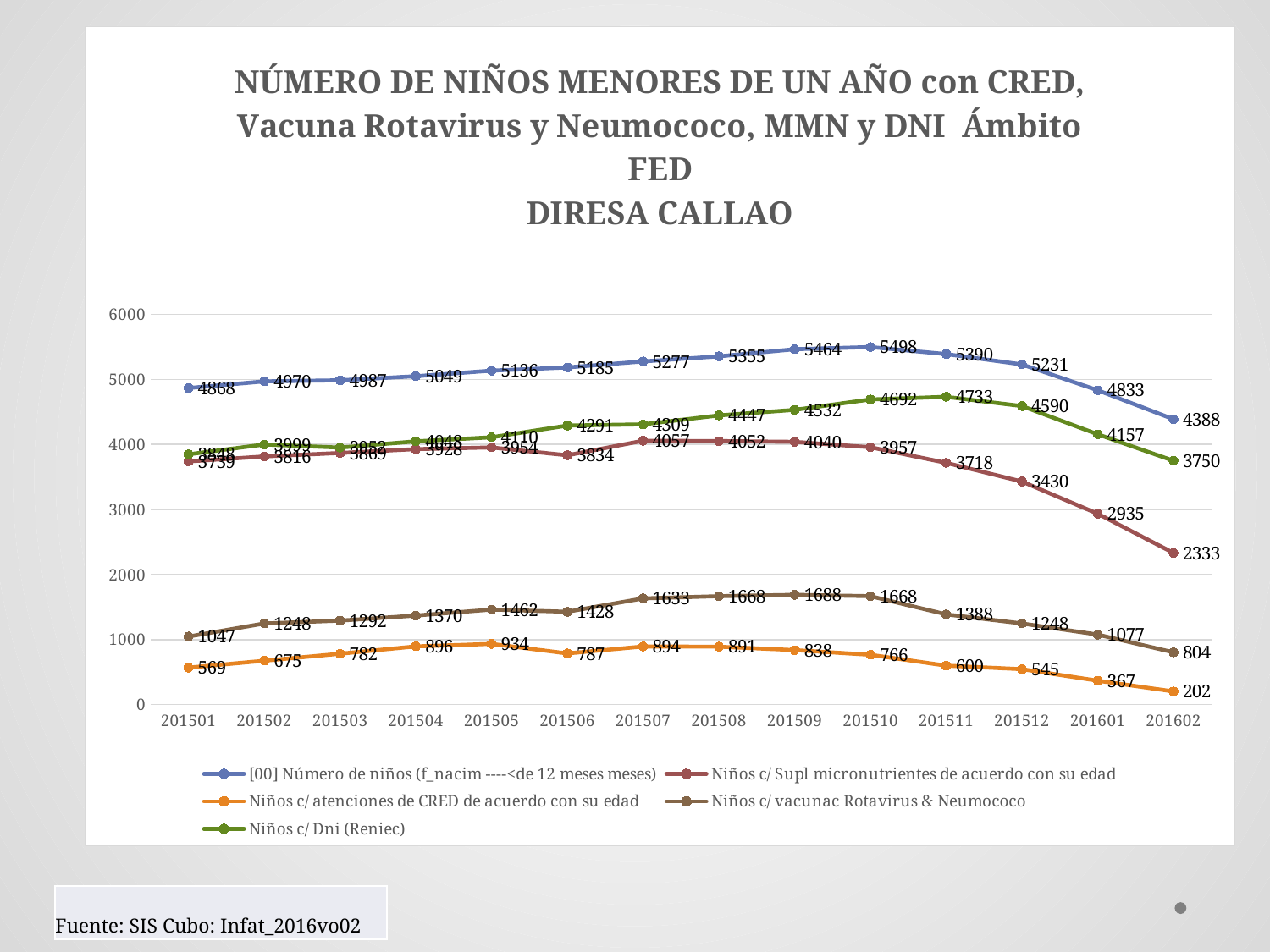
How many series does the legend list? 5 What is the value of 'Niños c/ Supl micronutrientes de acuerdo con su edad' at 201601? 2935 What is the value of 'Niños c/ atenciones de CRED de acuerdo con su edad' at 201602? 202 At 201602, which is larger: 'Niños c/ Dni (Reniec)' or 'Niños c/ Supl micronutrientes de acuerdo con su edad'? Niños c/ Dni (Reniec) What is the difference between the '[00] Número de niños' values at 201510 and 201602? 1110 What is the value of the '[00] Número de niños' series at 201510? 5498 How many months are shown on the x axis? 14 Is the value for 'Niños c/ Dni (Reniec)' at 201511 greater or less than 4000? greater What is the value of 'Niños c/ vacunac Rotavirus & Neumococo' at 201509? 1688 What kind of chart is shown on the slide? line chart In which month does the '[00] Número de niños' series reach its highest value? 201510 In which month is 'Niños c/ atenciones de CRED de acuerdo con su edad' at its lowest? 201602